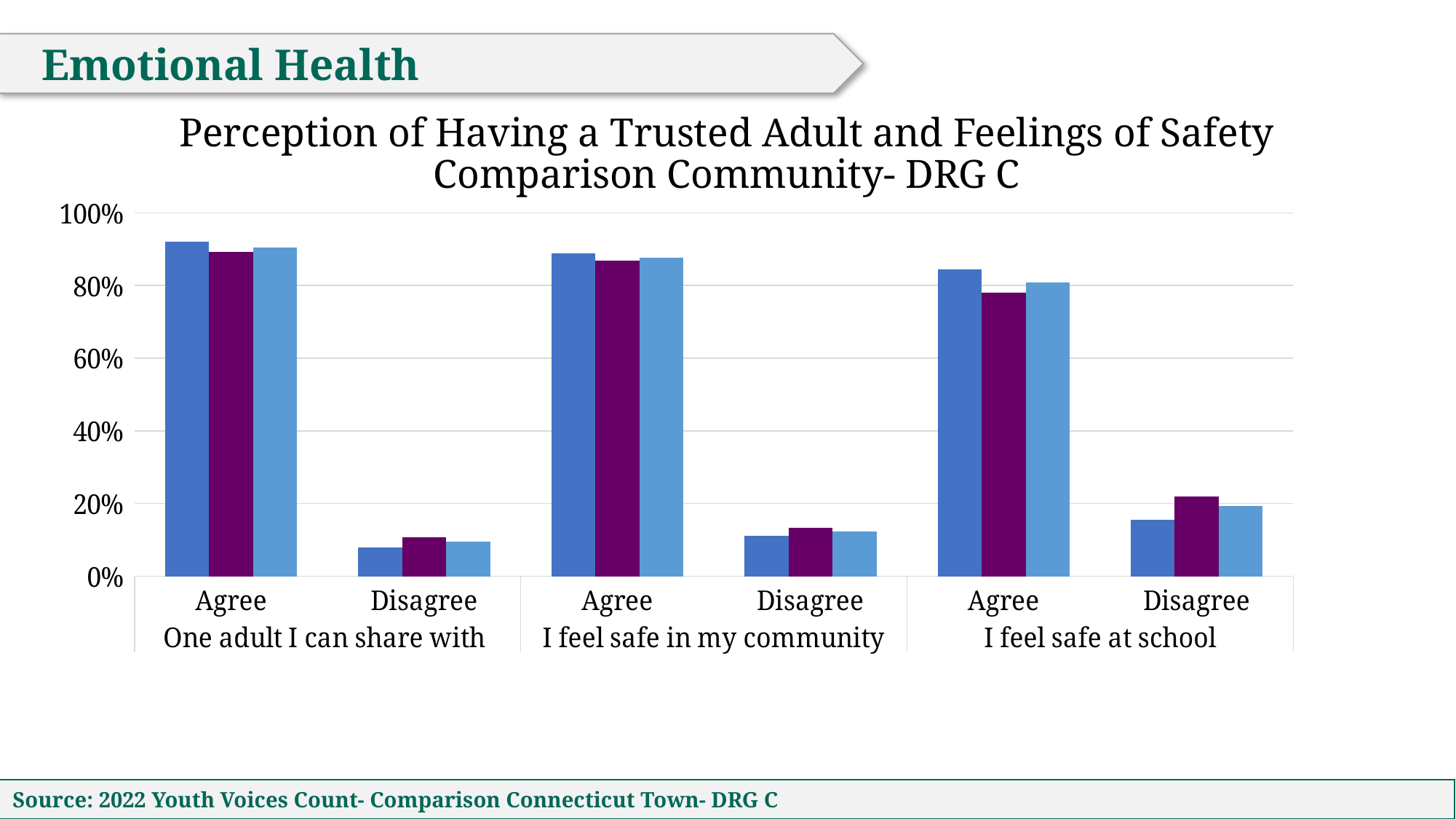
What kind of chart is shown on the slide? bar chart Which is larger, Disagree for 'I feel safe at school' or Disagree for 'One adult I can share with'? Disagree for 'I feel safe at school' Which statement has the highest Agree values? One adult I can share with What is the title of the chart? Perception of Having a Trusted Adult and Feelings of Safety Comparison Community- DRG C Do the Agree values rise or fall moving from 'One adult I can share with' to 'I feel safe at school'? fall How many Agree/Disagree category groups are shown along the x axis? 6 How many statements are compared along the x axis of the chart? 3 Is the value for Agree under 'One adult I can share with' greater or less than 80%? greater Is the value for Disagree under 'I feel safe at school' greater or less than 40%? less Which statement has the lowest Agree values? I feel safe at school Is the value for Disagree under 'I feel safe in my community' greater or less than 20%? less Under 'I feel safe at school', which is larger, Agree or Disagree? Agree